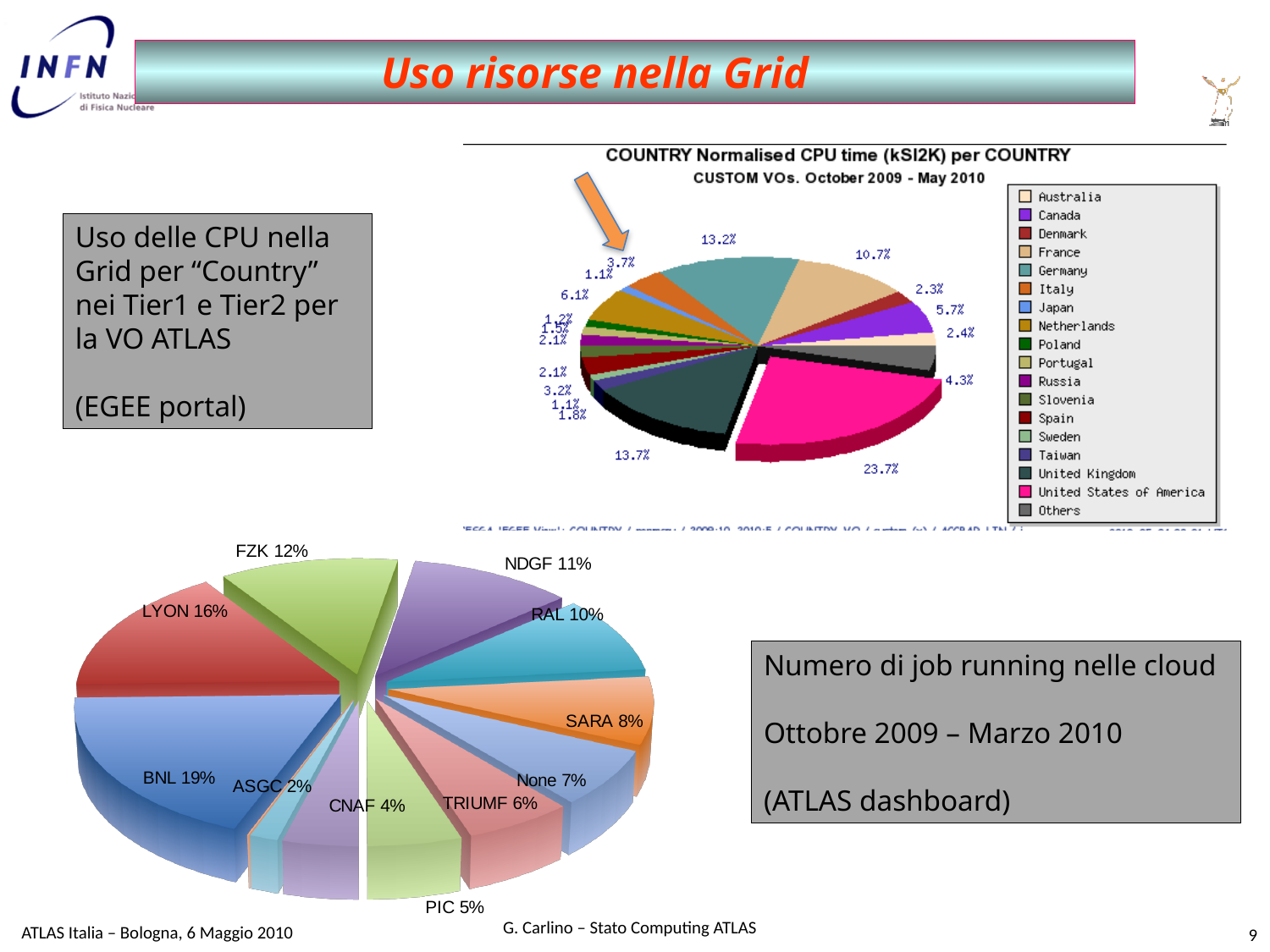
What kind of chart is the bottom-left chart? Pie chart In the bottom-left pie chart, what share does LYON have? 16% In the bottom-left pie chart, what share does TRIUMF have? 6% In the bottom-left pie chart, which is larger, FZK or NDGF? FZK How many slices does the bottom-left pie chart have? 11 What is the subtitle shown under the title of the top-right pie chart? CUSTOM VOs. October 2009 - May 2010 In the bottom-left pie chart, what is the difference in percentage points between BNL and LYON? 3 percentage points In the bottom-left pie chart, which cloud has the largest share? BNL In the bottom-left pie chart, what share does BNL have? 19% In the bottom-left pie chart, which cloud has the smallest share? ASGC In the chart titled 'COUNTRY Normalised CPU time (kSI2K) per COUNTRY', what is the largest percentage shown on a slice? 23.7% How many entries does the legend of the 'COUNTRY Normalised CPU time (kSI2K) per COUNTRY' chart list? 18